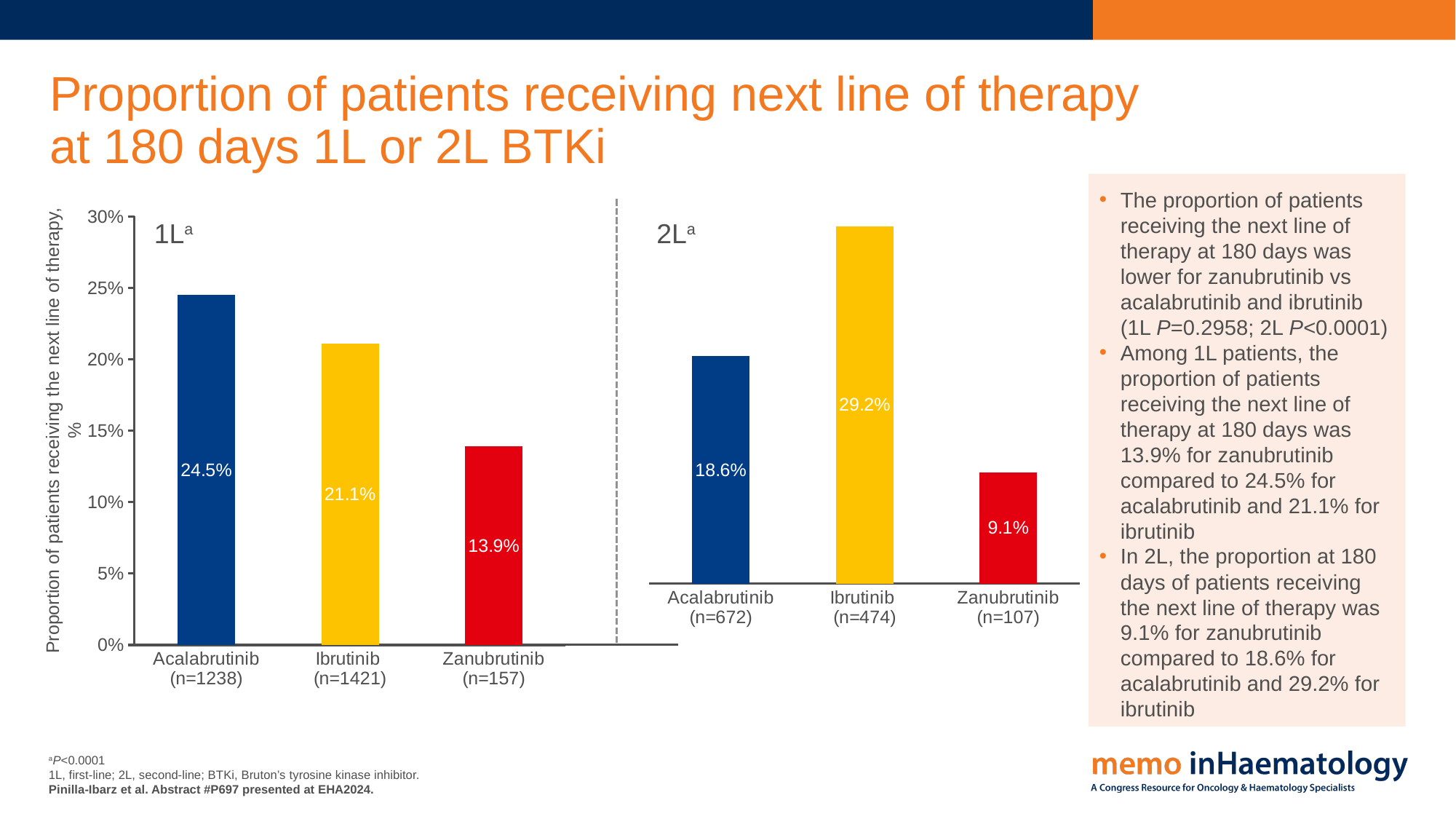
In the 2L chart, which drug has the lowest proportion? Zanubrutinib In the 2L chart, is the value for Acalabrutinib greater or less than 20%? less In the 1L chart, what is the proportion of patients receiving the next line of therapy for Acalabrutinib? 24.5% In the 2L chart, what is the value for Ibrutinib? 29.2% In the 2L chart, which drug has the highest proportion? Ibrutinib In the 2L chart, what is the difference between the values for Ibrutinib and Zanubrutinib? 20.1 percentage points What type of chart is used to show the 1L and 2L data? Bar chart How many drug categories are shown in the 1L chart? 3 In the 1L chart, what is the difference between the values for Acalabrutinib and Zanubrutinib? 10.6 percentage points In the 2L chart, what is the value for Zanubrutinib? 9.1% In the 1L chart, which is larger, the value for Ibrutinib or the value for Zanubrutinib? Ibrutinib In the 1L chart, which drug has the highest proportion of patients receiving the next line of therapy? Acalabrutinib